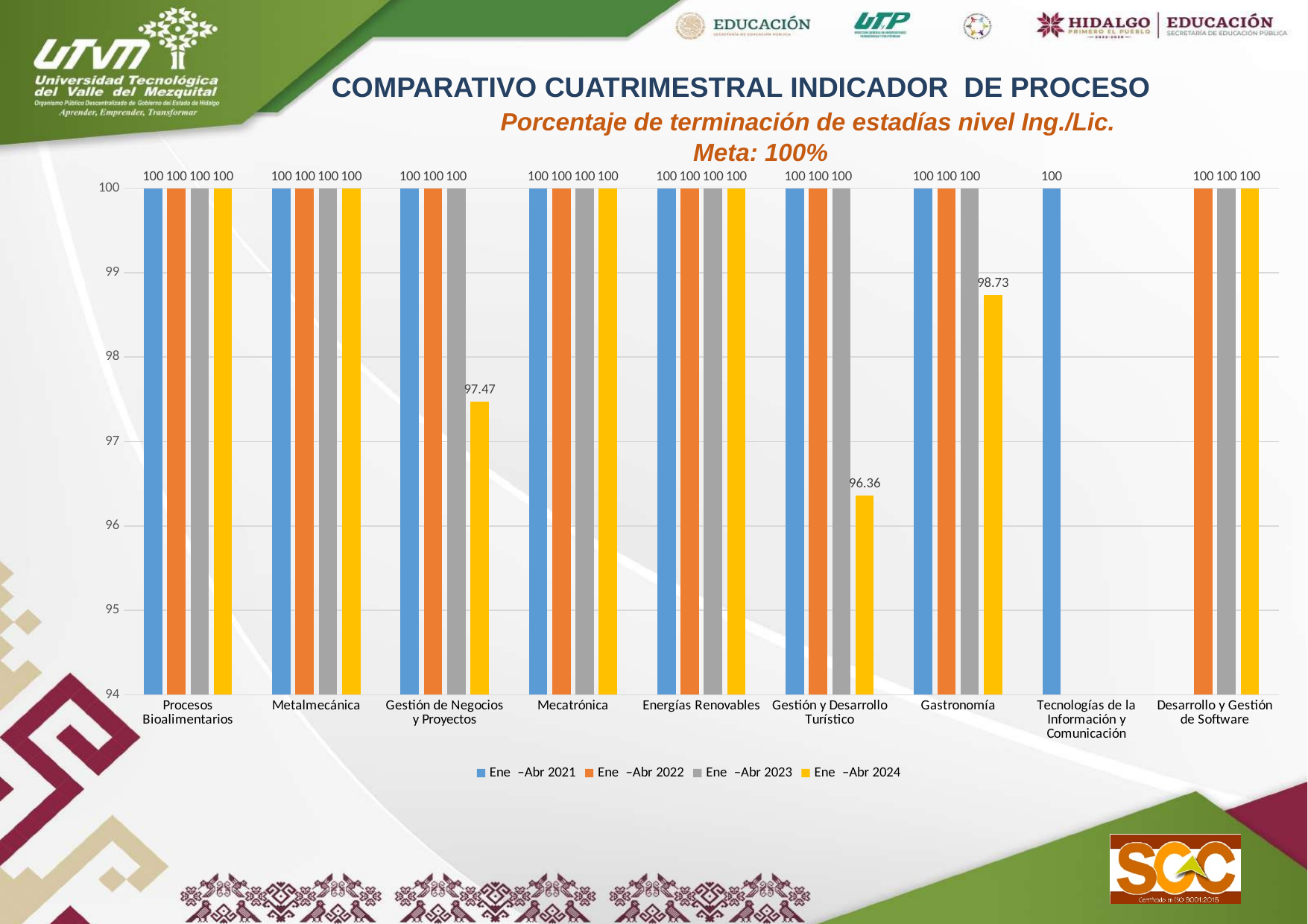
What kind of chart is shown on the slide? bar chart Which is larger for Ene–Abr 2024: Gastronomía or Gestión y Desarrollo Turístico? Gastronomía What is the difference between the Ene–Abr 2024 values for Gastronomía and Gestión de Negocios y Proyectos? 1.26 What is the Ene–Abr 2024 value for Gestión de Negocios y Proyectos? 97.47 What is the difference between the Ene–Abr 2023 and Ene–Abr 2024 values for Gestión y Desarrollo Turístico? 3.64 What is the Ene–Abr 2021 value for Tecnologías de la Información y Comunicación? 100 Which category has the lowest Ene–Abr 2024 value? Gestión y Desarrollo Turístico Is the Ene–Abr 2024 value for Gestión de Negocios y Proyectos greater or less than 98? less How many categories are shown on the x axis? 9 How many series does the legend list? 4 What is the Ene–Abr 2024 value for Gestión y Desarrollo Turístico? 96.36 What is the Ene–Abr 2024 value for Gastronomía? 98.73